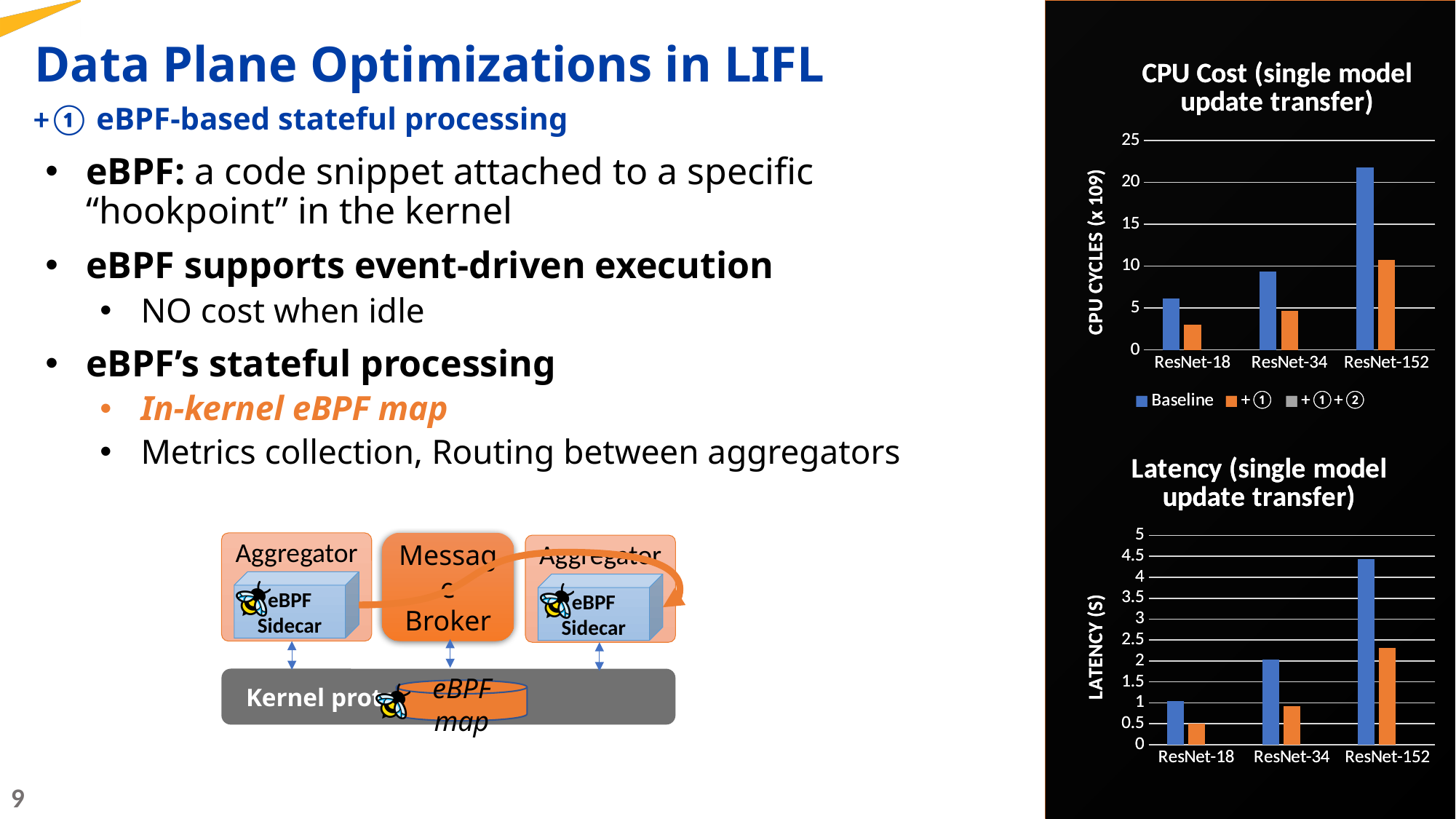
In the "Latency (single model update transfer)" chart, which is larger for ResNet-152: the Baseline value or the +① value? Baseline How many series does the legend of the "CPU Cost (single model update transfer)" chart list? 3 In the "Latency (single model update transfer)" chart, is the +① value for ResNet-34 greater or less than 1? less What kind of chart is the "CPU Cost (single model update transfer)" chart? bar chart In the "CPU Cost (single model update transfer)" chart, is the Baseline value for ResNet-34 greater or less than 10? less In the "CPU Cost (single model update transfer)" chart, is the Baseline value for ResNet-152 greater or less than 20? greater How many categories are shown on the x axis of the "Latency (single model update transfer)" chart? 3 In the "CPU Cost (single model update transfer)" chart, do the Baseline values rise or fall from ResNet-18 to ResNet-152? rise In the "Latency (single model update transfer)" chart, which category has the lowest Baseline value? ResNet-18 What is the y-axis title of the "Latency (single model update transfer)" chart? LATENCY (S) In the "CPU Cost (single model update transfer)" chart, which category has the highest Baseline value? ResNet-152